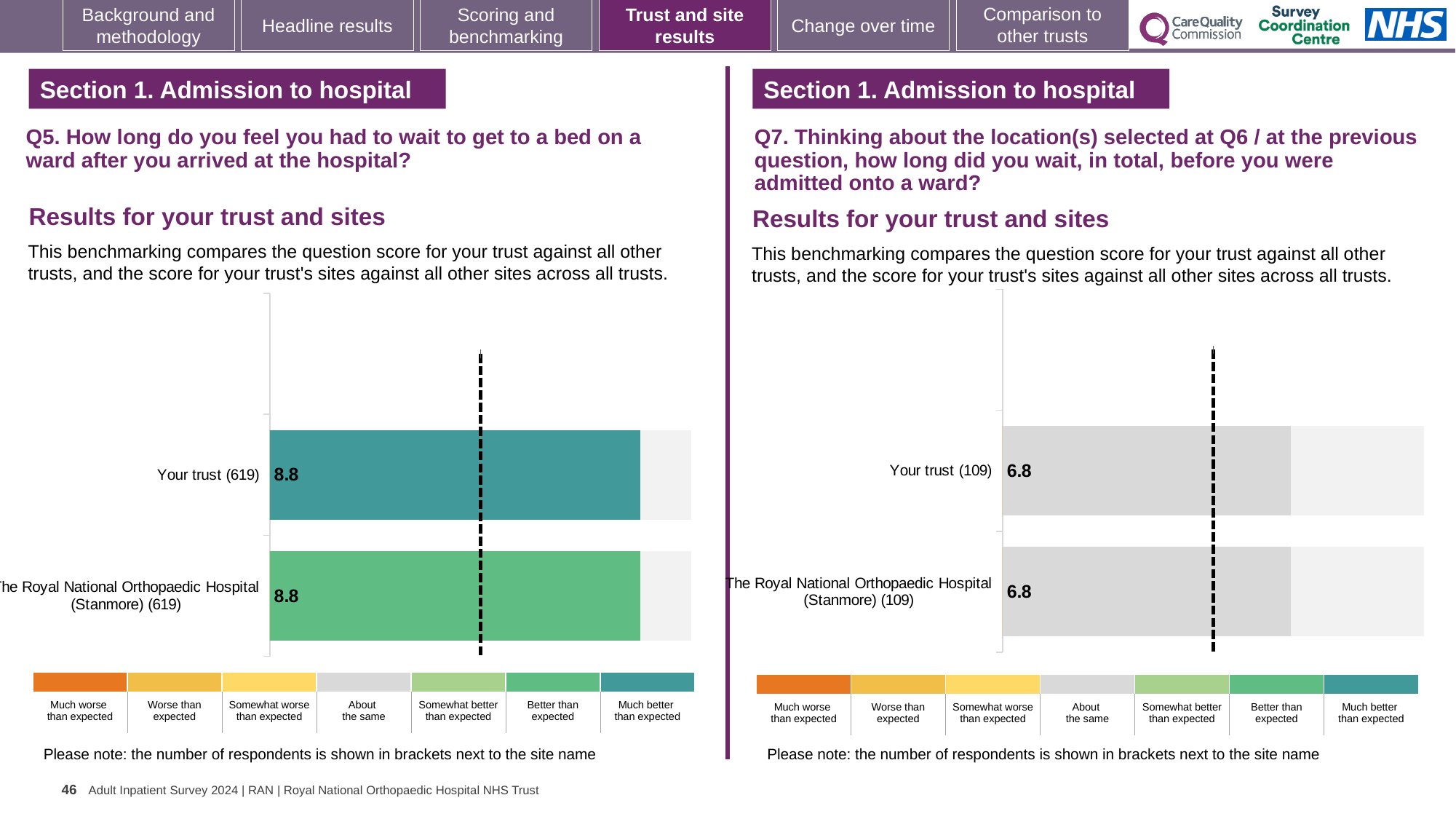
In the Q7 chart on the right, what is the score for Your trust? 6.8 In the Q7 chart on the right, how many respondents are shown in brackets for The Royal National Orthopaedic Hospital (Stanmore)? 109 In the Q7 chart on the right, what is the score for The Royal National Orthopaedic Hospital (Stanmore)? 6.8 In the Q5 chart on the left, what is the score for Your trust? 8.8 In the Q7 chart on the right, which benchmark category does the grey colour of the Your trust bar correspond to in the legend? About the same In the Q5 chart on the left, what is the difference between the score for Your trust and the score for The Royal National Orthopaedic Hospital (Stanmore)? 0 In the Q5 chart on the left, what is the score for The Royal National Orthopaedic Hospital (Stanmore)? 8.8 In the Q7 chart on the right, what is the difference between the score for Your trust and the score for The Royal National Orthopaedic Hospital (Stanmore)? 0 In the Q5 chart on the left, how many respondents are shown in brackets for Your trust? 619 What kind of chart is the Q5 chart on the left? Bar chart How many bars are plotted in the Q7 chart on the right? 2 How many bars are plotted in the Q5 chart on the left? 2